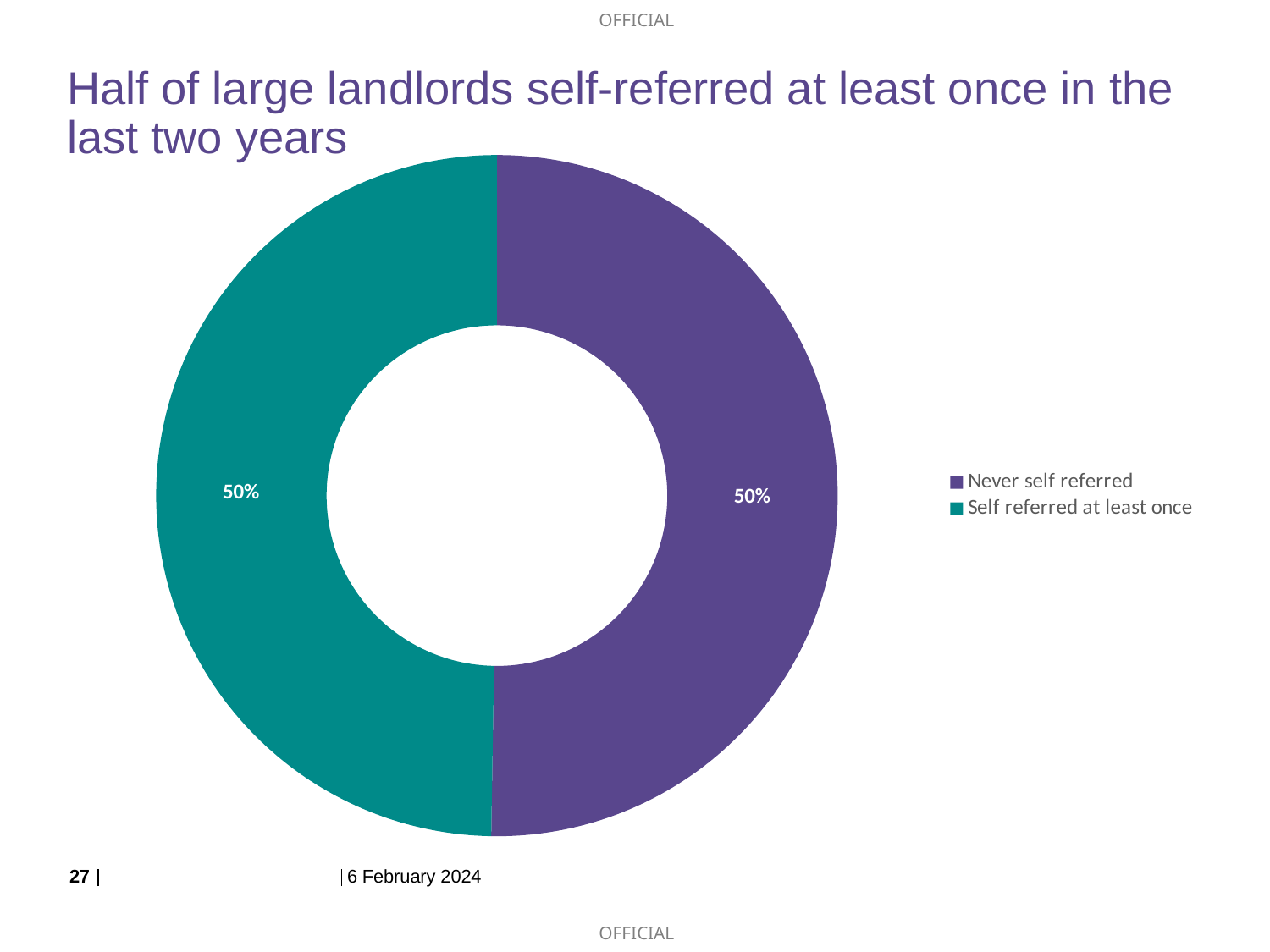
What colour is the 'Self referred at least once' slice? Teal How many categories does the chart show? 2 What colour is the 'Never self referred' slice? Purple What is the total of the two slices shown in the chart? 100% How many entries does the legend list? 2 What share of the pie does the 'Self referred at least once' slice take? 50% Is the value for 'Self referred at least once' greater or less than 75%? less What percentage of large landlords self referred at least once? 50% What is the difference between the share of landlords who never self referred and those who self referred at least once? 0% What kind of chart is shown on the slide? Pie chart (doughnut) Is the value for 'Never self referred' greater or less than 25%? greater What percentage of large landlords never self referred? 50%